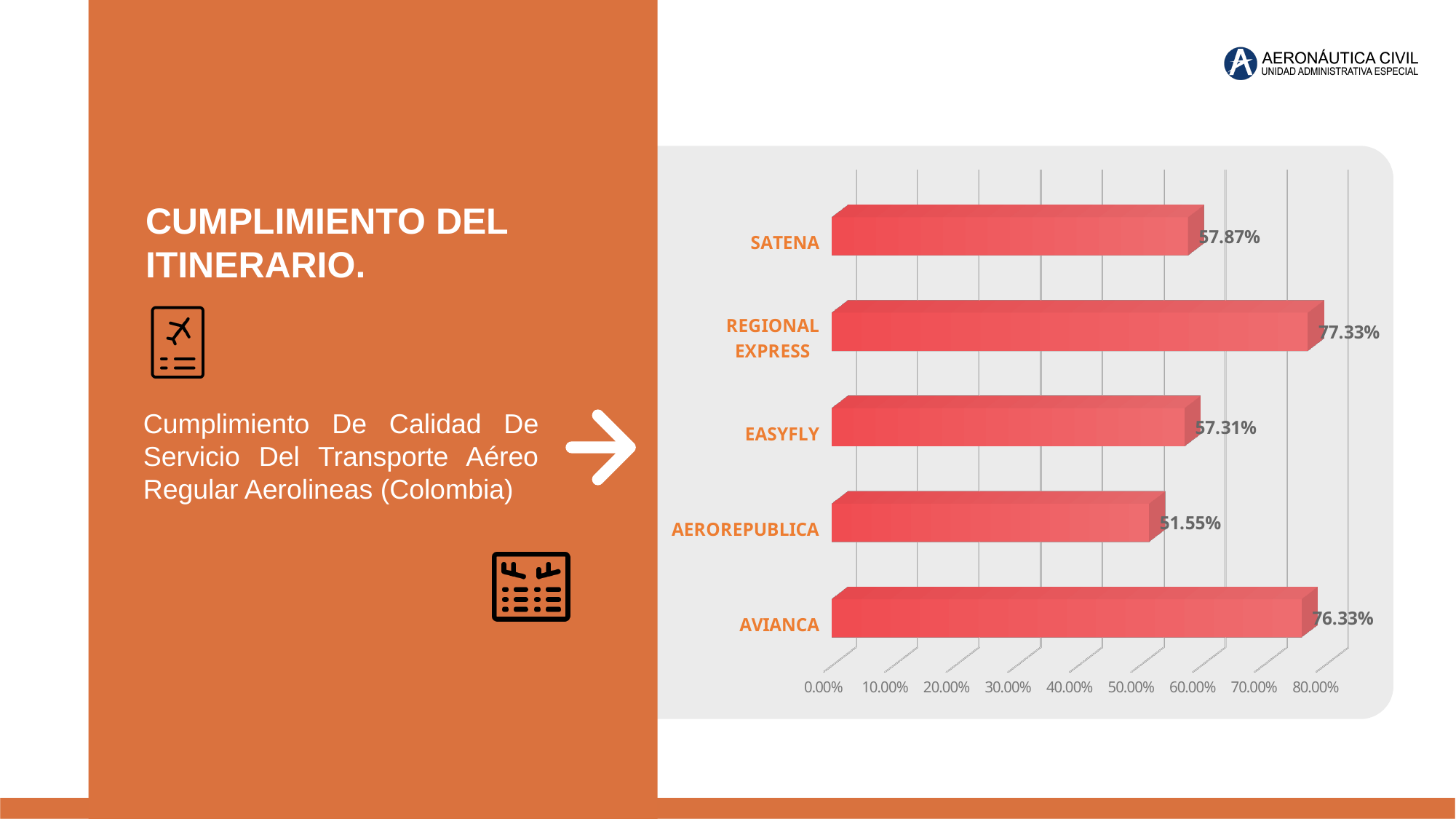
What is the value for AEROREPUBLICA? 51.55% What is the value for AVIANCA? 76.33% Which airline has the lowest value? AEROREPUBLICA What kind of chart is shown on the slide? bar chart What is the difference between the values for REGIONAL EXPRESS and AVIANCA? 1.00% What is the value for SATENA? 57.87% Which is larger, the value for AVIANCA or the value for EASYFLY? AVIANCA Is the value for EASYFLY greater or less than 60.00%? less What is the difference between the values for SATENA and AEROREPUBLICA? 6.32% How many airlines are shown in the chart? 5 What is the value for REGIONAL EXPRESS? 77.33% Which airline has the highest value? REGIONAL EXPRESS